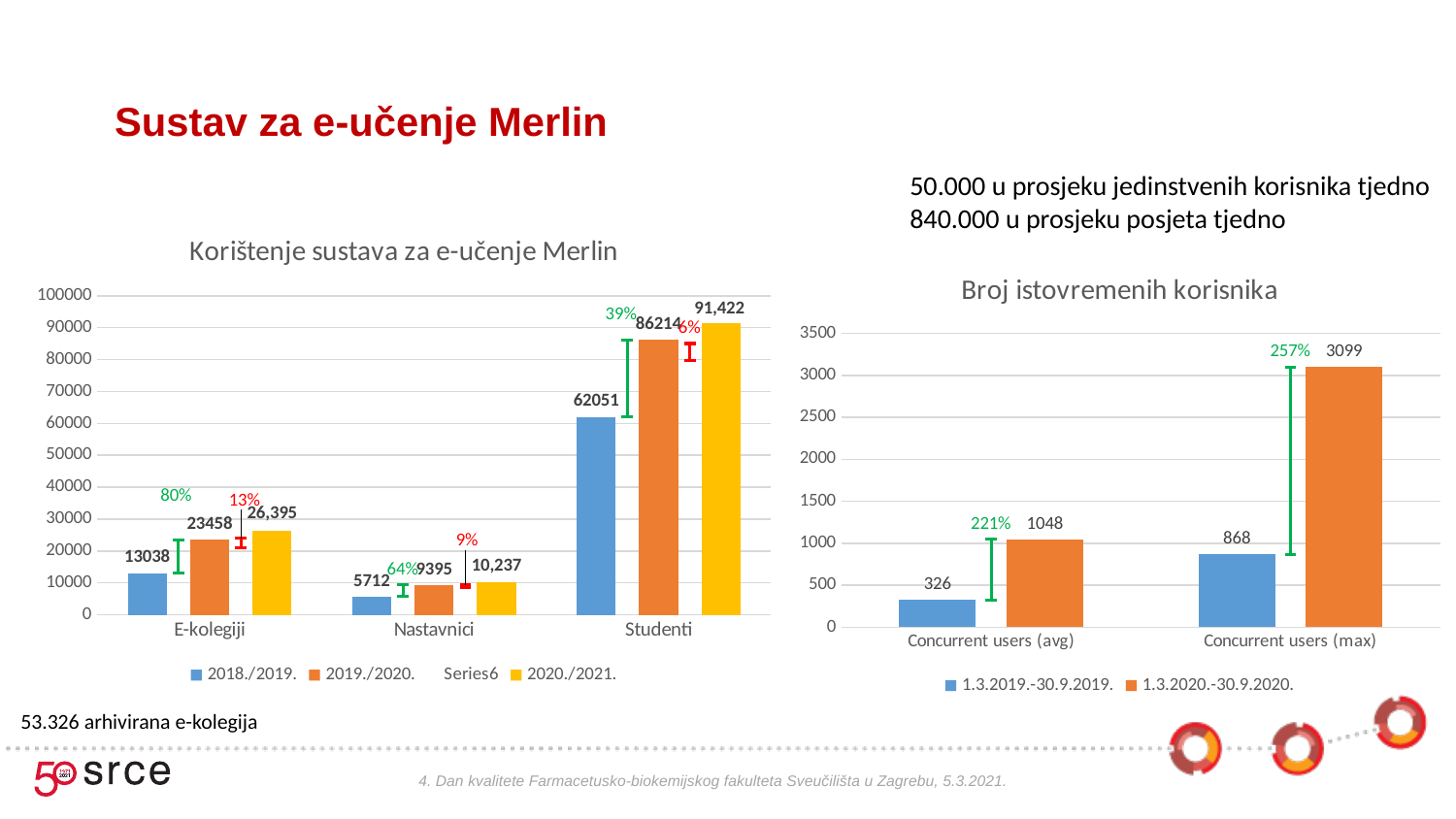
What type of chart is 'Broj istovremenih korisnika'? bar chart In the chart 'Broj istovremenih korisnika', what is the value for Concurrent users (max) in the period 1.3.2020.-30.9.2020.? 3099 In the chart 'Korištenje sustava za e-učenje Merlin', what is the value for Studenti in 2020./2021.? 91,422 In the chart 'Korištenje sustava za e-učenje Merlin', how many categories are shown on the x axis? 3 In the chart 'Korištenje sustava za e-učenje Merlin', do the values for Nastavnici rise or fall from 2018./2019. to 2020./2021.? rise In the chart 'Korištenje sustava za e-učenje Merlin', what is the difference between the 2020./2021. and 2018./2019. values for Studenti? 29371 In the chart 'Broj istovremenih korisnika', how many series does the legend list? 2 In the chart 'Korištenje sustava za e-učenje Merlin', what is the value for Nastavnici in 2019./2020.? 9395 In the chart 'Korištenje sustava za e-učenje Merlin', which category has the highest values? Studenti In the chart 'Broj istovremenih korisnika', what is the difference between the two periods for Concurrent users (max)? 2231 In the chart 'Korištenje sustava za e-učenje Merlin', what is the value for E-kolegiji in 2018./2019.? 13038 In the chart 'Broj istovremenih korisnika', what is the value for Concurrent users (avg) in the period 1.3.2019.-30.9.2019.? 326